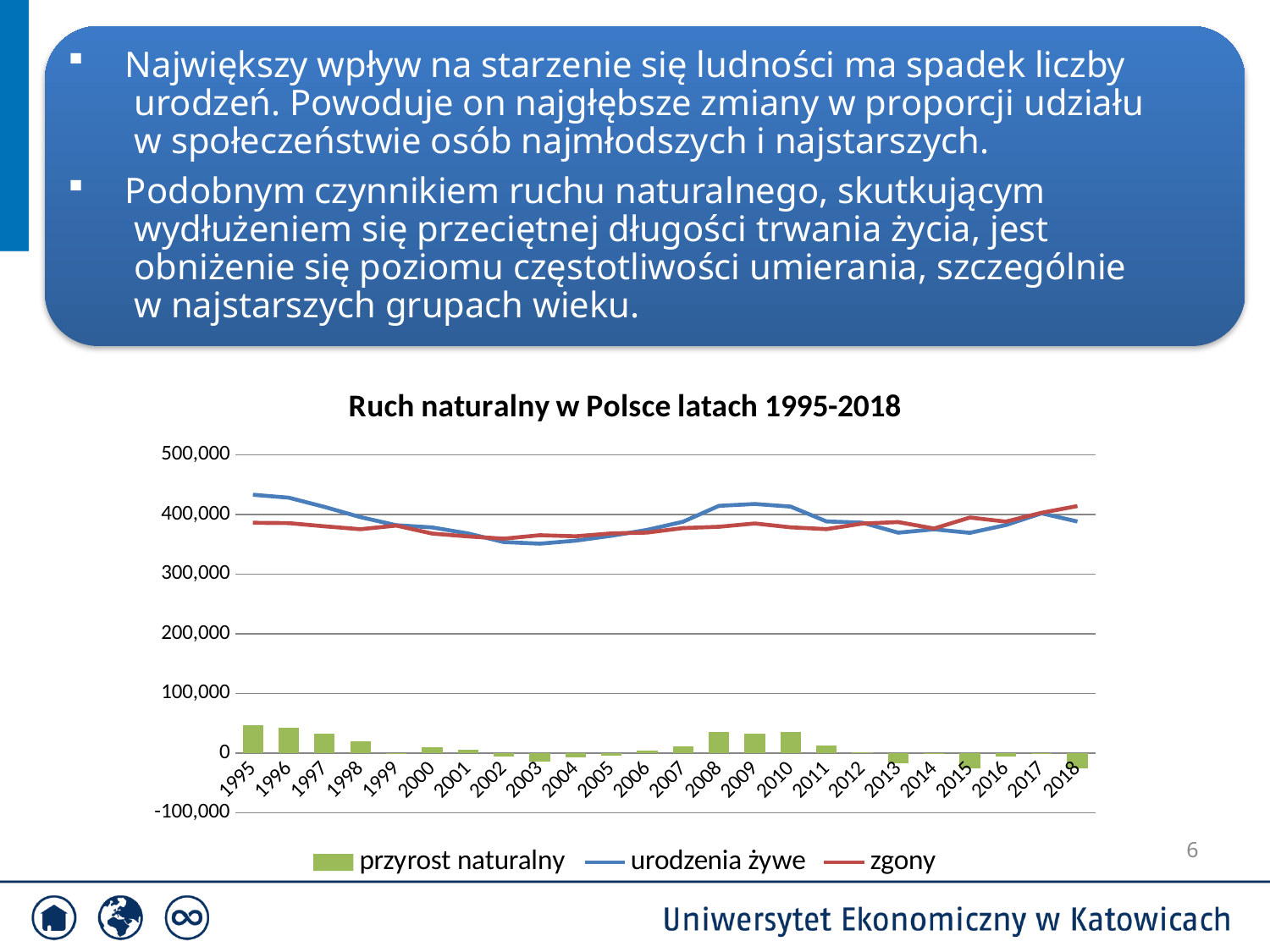
Does the urodzenia żywe line rise or fall from 1995 to 2003? fall Is the value of urodzenia żywe in 2003 greater or less than 400,000? less What is the title of the chart? Ruch naturalny w Polsce latach 1995-2018 In 2018, which is larger: urodzenia żywe or zgony? zgony In which year is the przyrost naturalny bar the tallest? 1995 How many series does the chart legend list? 3 In 1995, which is larger: urodzenia żywe or zgony? urodzenia żywe Is the value of przyrost naturalny in 1995 greater or less than 100,000? less Is the value of urodzenia żywe in 1995 greater or less than 400,000? greater How many years are shown on the x axis of the chart? 24 What kind of chart is shown on the slide? A combined bar and line chart